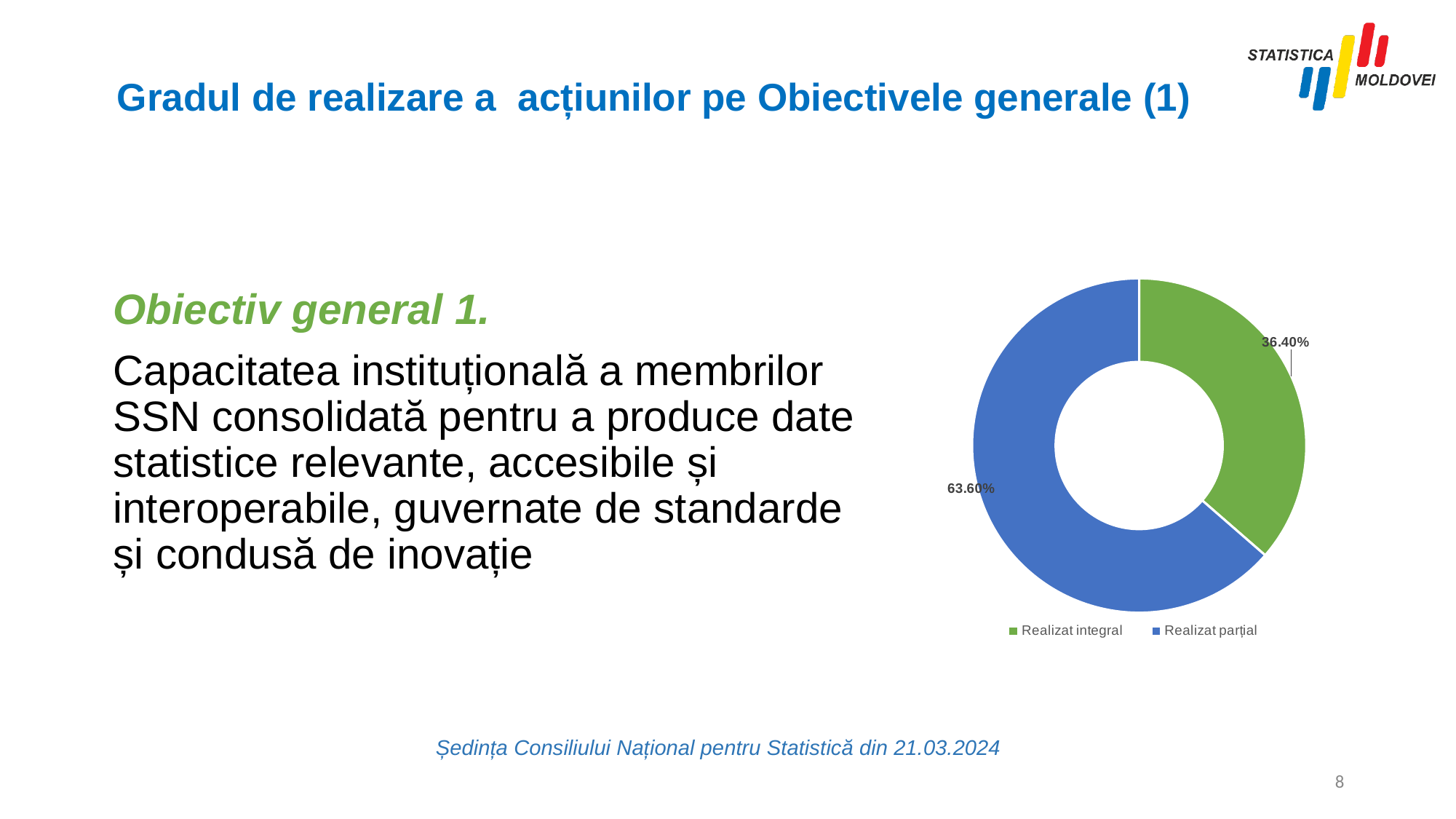
How many categories does the chart show? 2 What is the difference in percentage points between "Realizat parțial" and "Realizat integral"? 27.20 percentage points What share of the chart is labelled "Realizat integral"? 36.40% What colour is the "Realizat integral" slice? Green How many entries does the legend list? 2 Is the share for "Realizat parțial" greater or less than 50%? greater Which is larger: the share for "Realizat integral" or the share for "Realizat parțial"? Realizat parțial Which category has the largest share of the chart? Realizat parțial What kind of chart is shown on the slide? Doughnut (pie) chart Which category has the smallest share of the chart? Realizat integral What share of the chart is labelled "Realizat parțial"? 63.60% What colour is the "Realizat parțial" slice? Blue